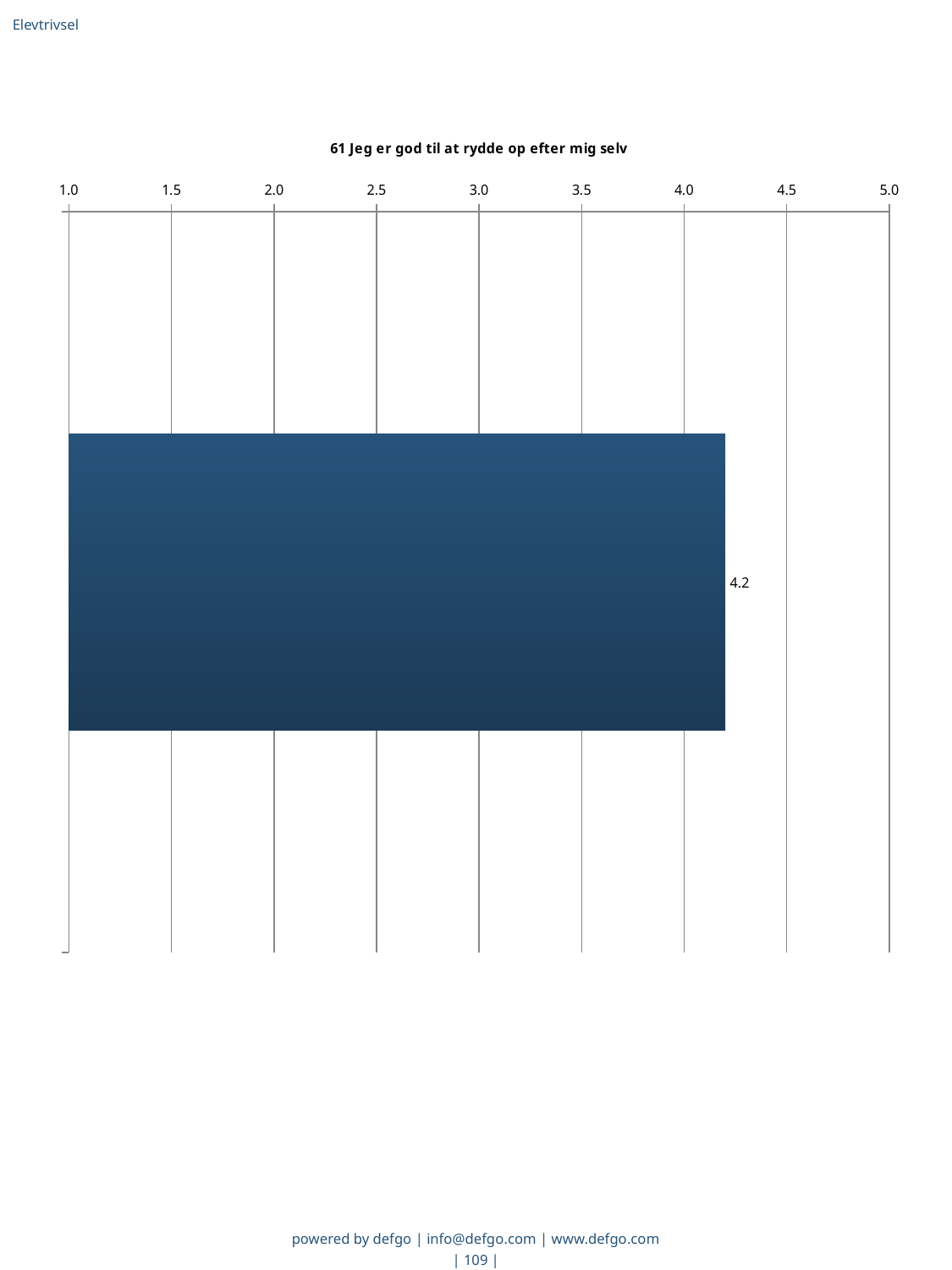
Is the value of the bar greater or less than 4.5? less Is the value of the bar greater or less than 4.0? greater Is the bar in the chart horizontal or vertical? horizontal What is the title of the chart? 61 Jeg er god til at rydde op efter mig selv What is the highest value shown on the chart's axis? 5.0 What kind of chart is shown on the slide? bar chart What is the value shown by the bar in the chart? 4.2 How many bars are plotted in the chart? 1